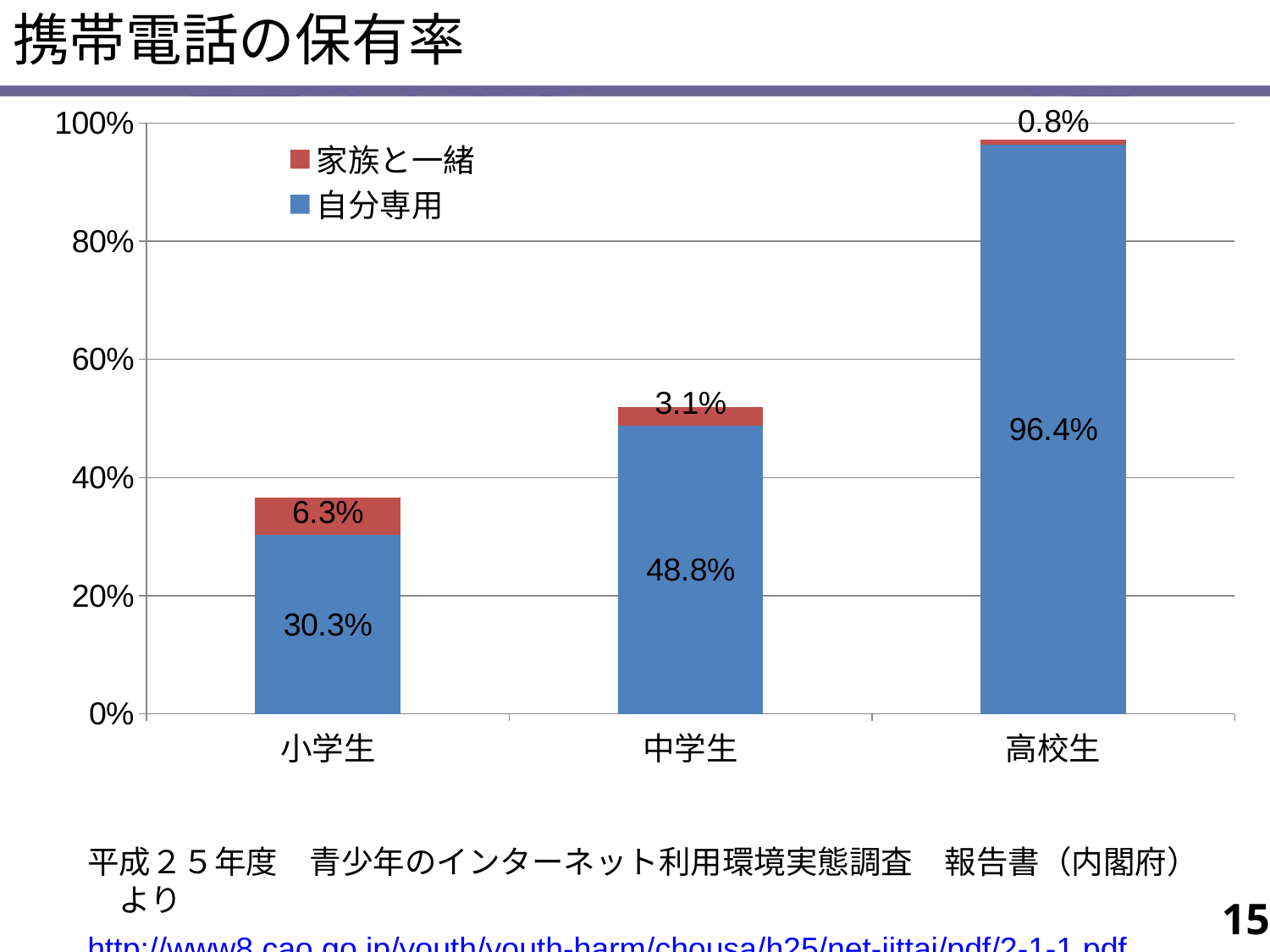
What is the 家族と一緒 value for 高校生? 0.8% Which category has the highest 自分専用 value? 高校生 What is the difference between the 自分専用 values for 中学生 and 小学生? 18.5% Does the 自分専用 value rise or fall from 小学生 to 高校生? rise What is the 自分専用 value for 小学生? 30.3% What is the total of the stacked bar for 小学生? 36.6% Which is larger: the 家族と一緒 value for 小学生 or for 中学生? 小学生 What is the 自分専用 value for 高校生? 96.4% Which category has the lowest 家族と一緒 value? 高校生 What is the 家族と一緒 value for 中学生? 3.1% How many series does the legend list? 2 How many categories are shown on the x axis? 3